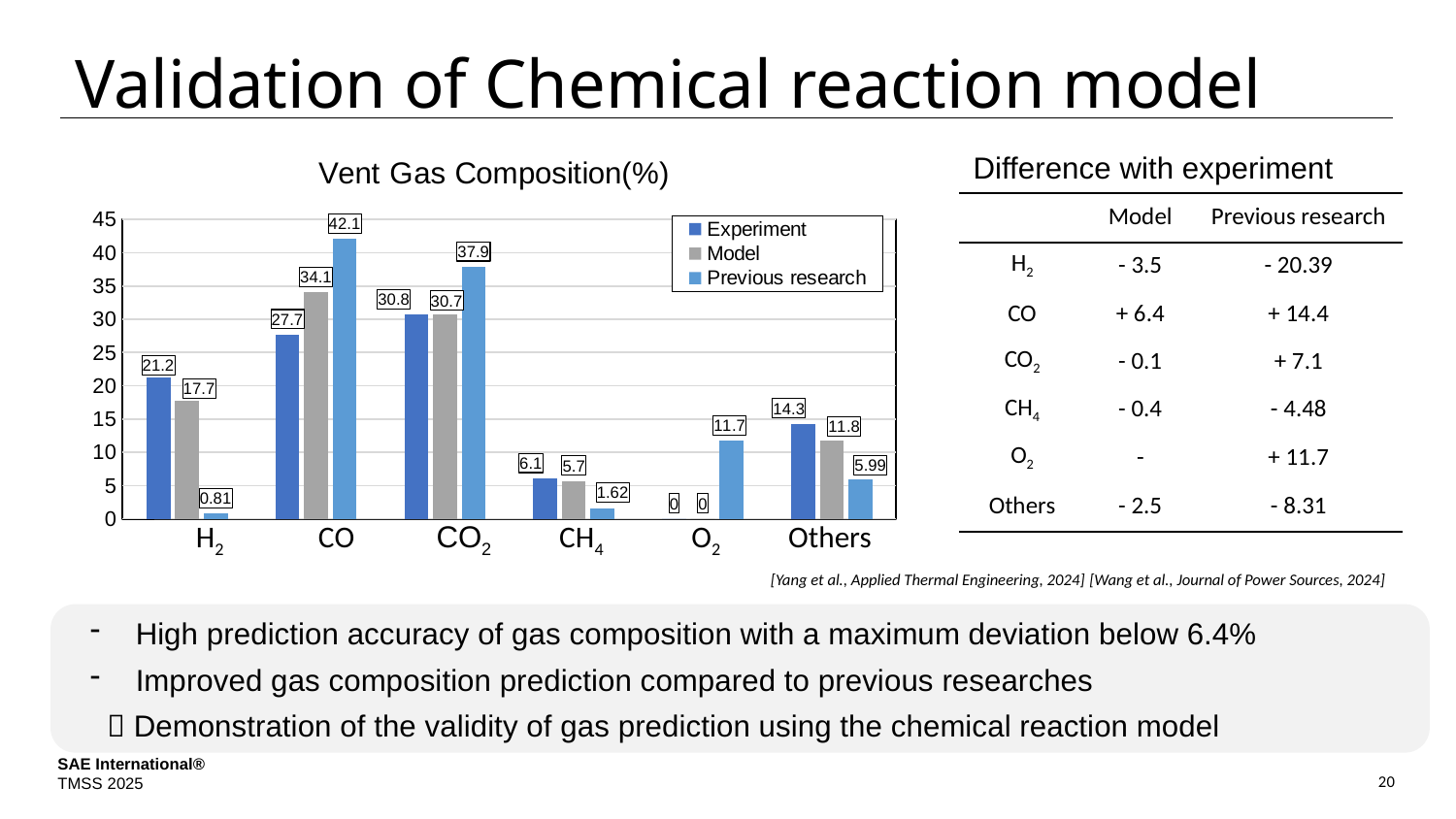
What is the Previous research value for O2 in the Vent Gas Composition chart? 11.7 How many categories are shown on the x axis of the Vent Gas Composition chart? 6 What is the title of the chart on the slide? Vent Gas Composition(%) Which category has the highest Previous research value in the Vent Gas Composition chart? CO What is the Model value for CH4 in the Vent Gas Composition chart? 5.7 What is the difference between the Model and Experiment values for CO in the Vent Gas Composition chart? 6.4 What is the Previous research value for CO in the Vent Gas Composition chart? 42.1 How many series does the legend of the Vent Gas Composition chart list? 3 What type of chart is the Vent Gas Composition chart? Bar chart Which is larger for Others in the Vent Gas Composition chart: the Experiment value or the Model value? Experiment Which category has the lowest Experiment value in the Vent Gas Composition chart? O2 What is the Experiment value for H2 in the Vent Gas Composition chart? 21.2